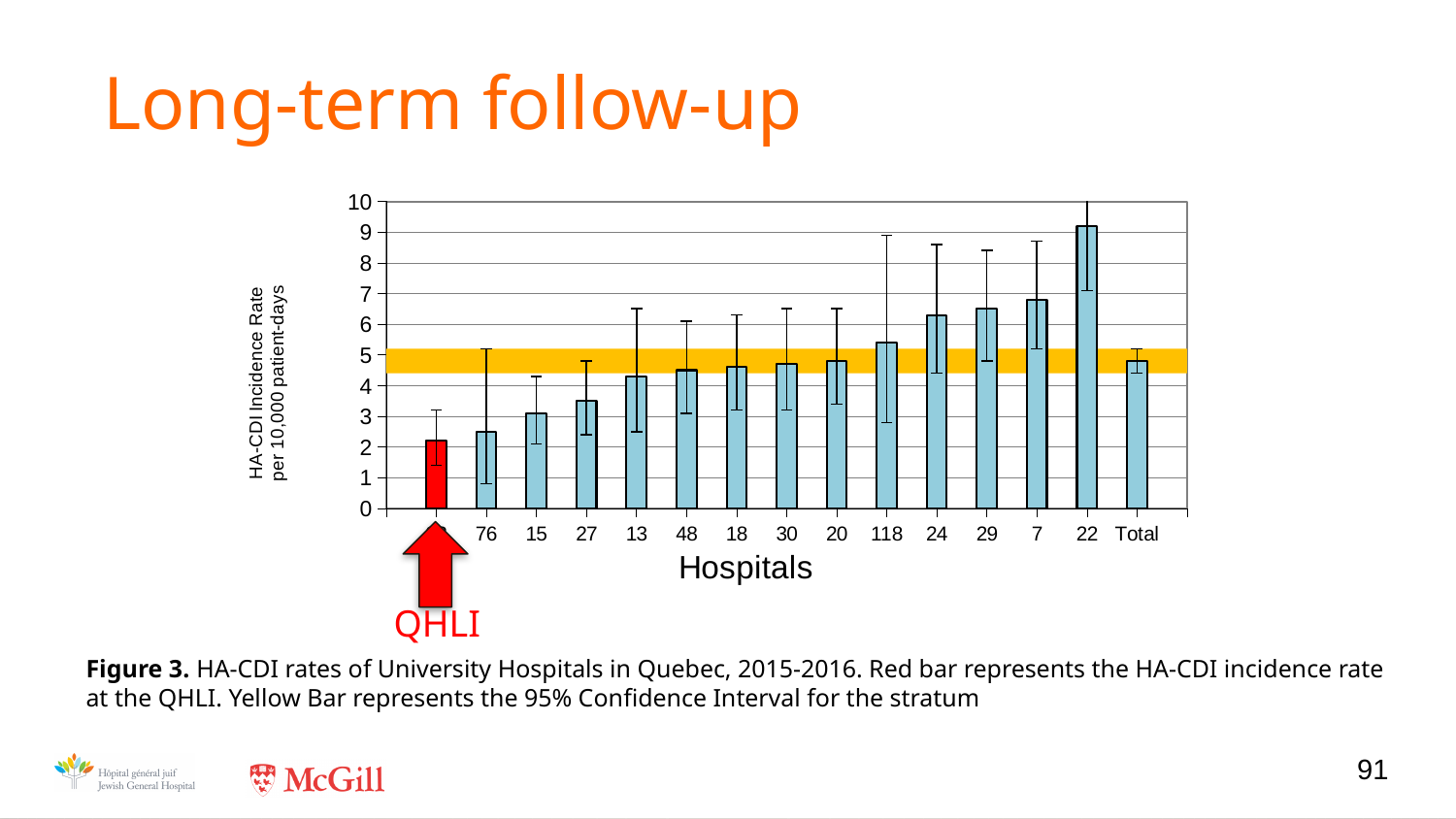
What does the red bar in the chart represent? the HA-CDI incidence rate at the QHLI What kind of chart is shown on the slide? bar chart Is the HA-CDI incidence rate for QHLI greater or less than 3? less Which hospital has the lowest HA-CDI incidence rate? QHLI Do the hospital bars rise or fall from left to right across the x axis (excluding Total)? rise Which has a higher HA-CDI incidence rate, hospital 22 or hospital 7? hospital 22 Which hospital has the highest HA-CDI incidence rate? 22 Is the HA-CDI incidence rate for hospital 15 greater or less than 4? less Is the HA-CDI incidence rate for hospital 7 greater or less than 6? greater Which has a higher HA-CDI incidence rate, hospital 118 or hospital 13? hospital 118 How many bars are plotted on the chart, including QHLI and Total? 15